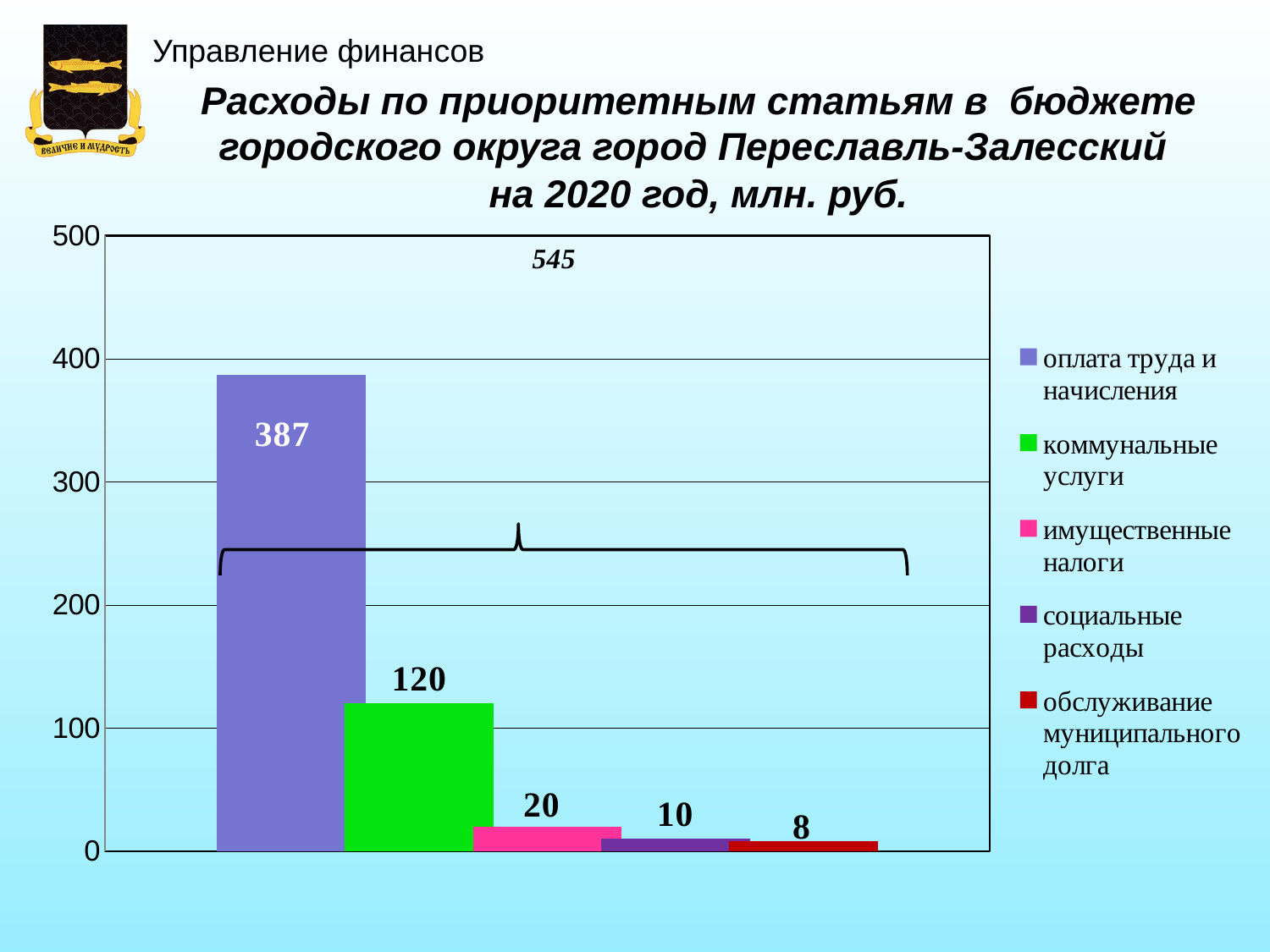
How many series does the legend list? 5 Which series has the highest value? оплата труда и начисления Is the value for оплата труда и начисления greater or less than 300? greater What is the value for имущественные налоги? 20 What kind of chart is shown on the slide? bar chart Which is larger, the value for социальные расходы or the value for имущественные налоги? имущественные налоги Which series has the lowest value? обслуживание муниципального долга What is the value for обслуживание муниципального долга? 8 What total is printed above the bars on the chart? 545 What is the difference between the values for оплата труда и начисления and коммунальные услуги? 267 What is the value for оплата труда и начисления? 387 What is the value for коммунальные услуги? 120